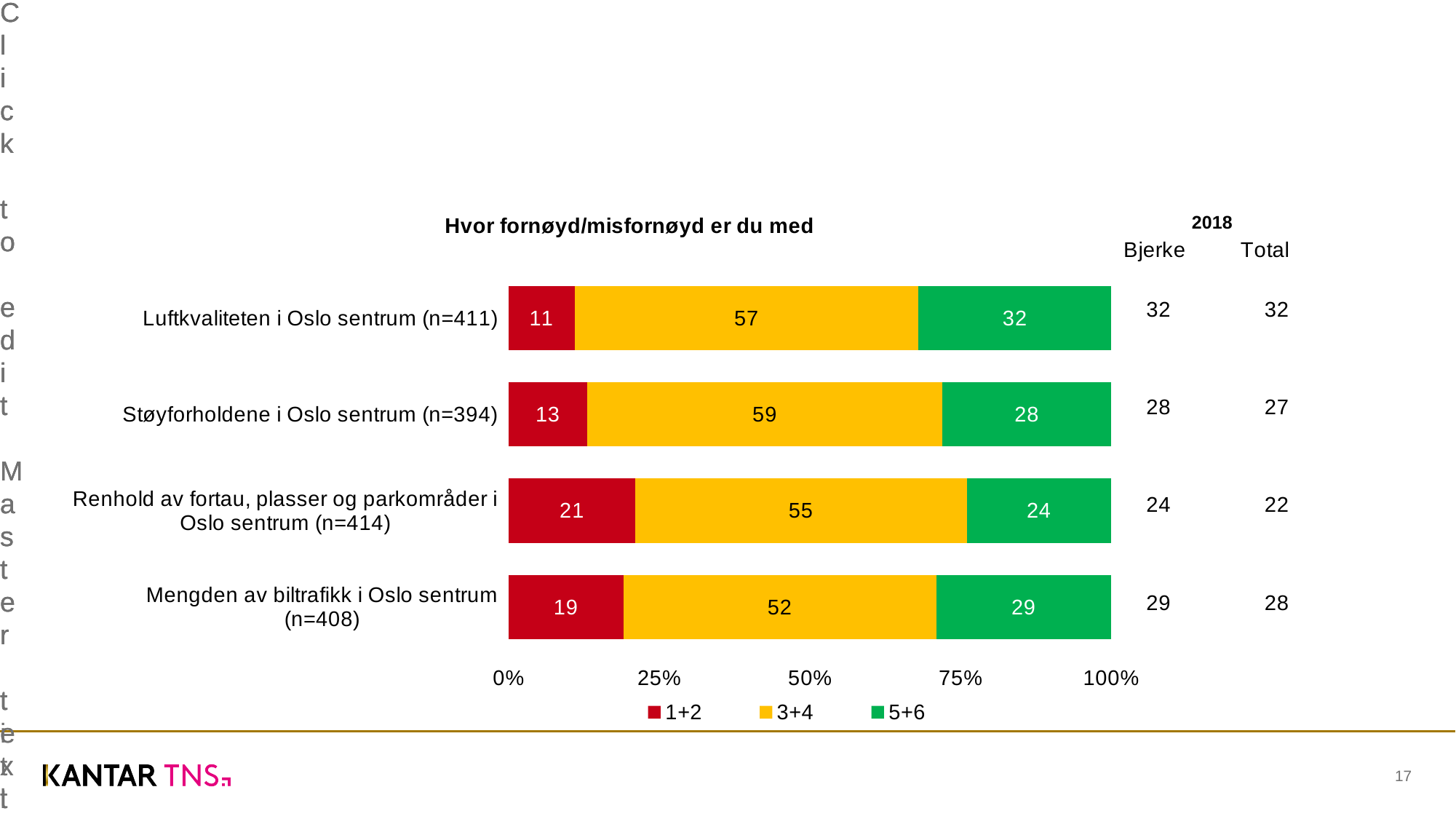
What is the value of the 5+6 segment for Mengden av biltrafikk i Oslo sentrum (n=408)? 29 What is the title of the chart? Hvor fornøyd/misfornøyd er du med What is the difference between the 3+4 values for Luftkvaliteten i Oslo sentrum (n=411) and Mengden av biltrafikk i Oslo sentrum (n=408)? 5 Which category has the highest 1+2 value? Renhold av fortau, plasser og parkområder i Oslo sentrum (n=414) What is the value of the 1+2 segment for Luftkvaliteten i Oslo sentrum (n=411)? 11 How many categories are shown in the chart? 4 Which category has the lowest 5+6 value? Renhold av fortau, plasser og parkområder i Oslo sentrum (n=414) How many series does the legend list? 3 Which is larger: the 5+6 value for Luftkvaliteten i Oslo sentrum (n=411) or for Støyforholdene i Oslo sentrum (n=394)? Luftkvaliteten i Oslo sentrum (n=411) What is the value of the 3+4 segment for Støyforholdene i Oslo sentrum (n=394)? 59 What kind of chart is shown on the slide? Stacked bar chart Which colour represents the 5+6 series in the legend? Green